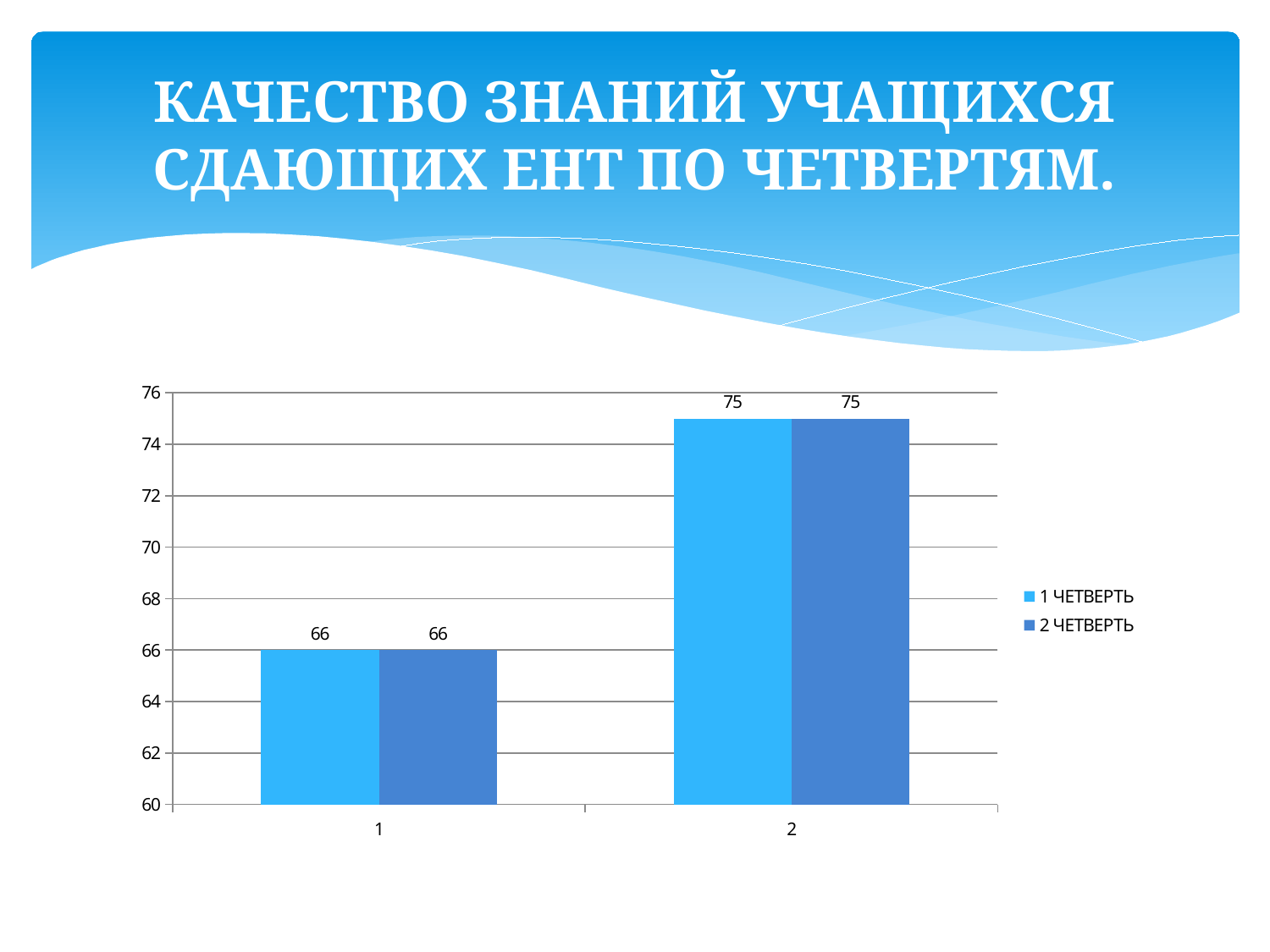
What is the value for category 2 in the 2 ЧЕТВЕРТЬ series? 75 What kind of chart is shown on the slide? bar chart Which is larger: the 2 ЧЕТВЕРТЬ value for category 1 or for category 2? category 2 Which category has the highest value in the 1 ЧЕТВЕРТЬ series? 2 What is the value for category 2 in the 1 ЧЕТВЕРТЬ series? 75 What is the difference between the 1 ЧЕТВЕРТЬ values for category 2 and category 1? 9 How many categories are shown on the x axis? 2 How many series does the legend list? 2 What is the value for category 1 in the 1 ЧЕТВЕРТЬ series? 66 Which category has the lowest value in the 2 ЧЕТВЕРТЬ series? 1 Is the 1 ЧЕТВЕРТЬ value for category 1 greater or less than 70? less Do the values rise or fall from category 1 to category 2? rise